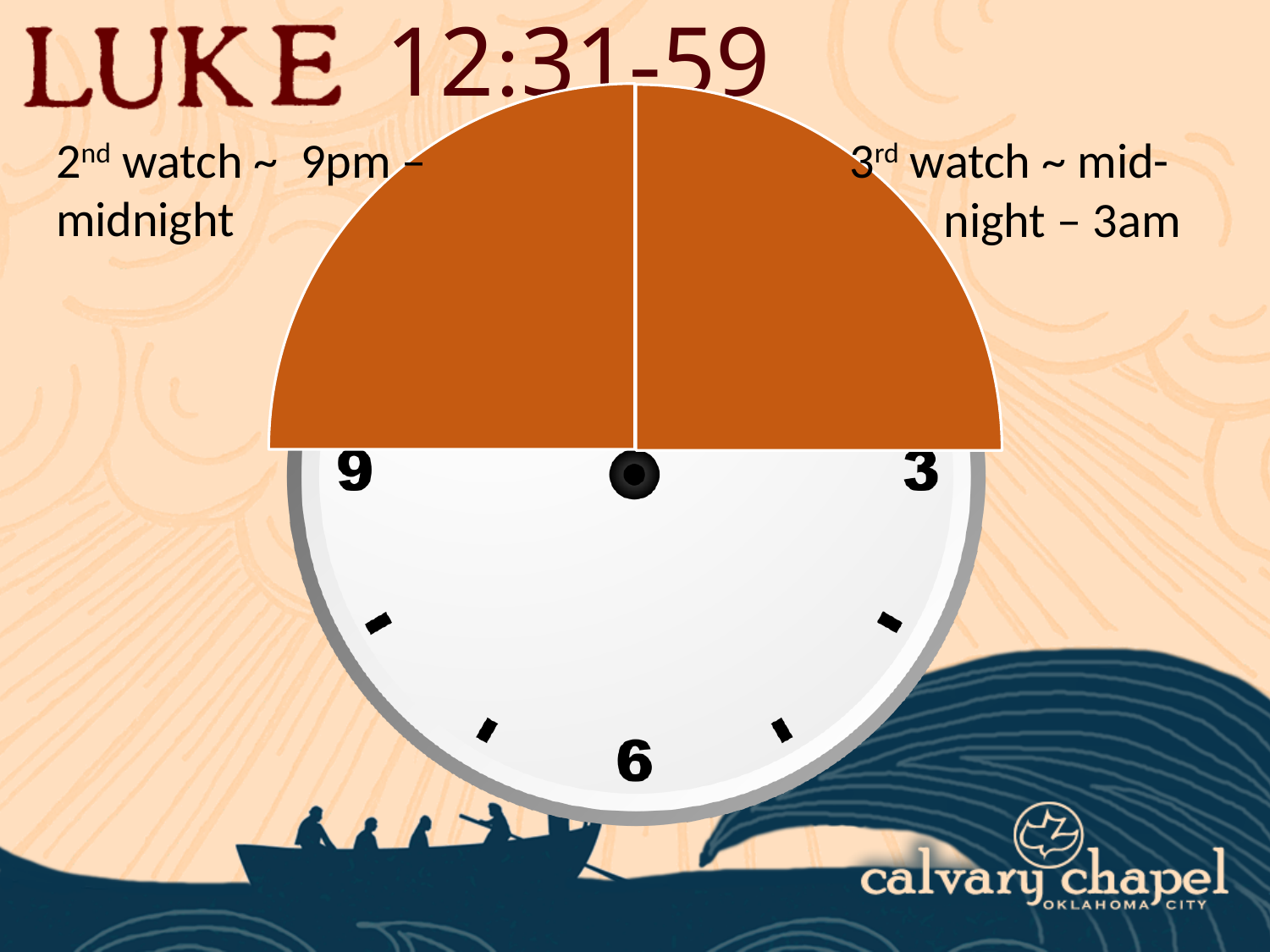
What is the title shown at the top of the slide? Luke 12:31-59 Which watch does the orange segment on the right side of the clock represent? 3rd watch What time range is given for the 2nd watch? 9pm – midnight Are the two orange segments on the clock the same size or different sizes? the same size Which watch does the orange segment on the left side of the clock represent? 2nd watch How many orange segments are drawn on the clock face? 2 What time range is given for the 3rd watch? midnight – 3am